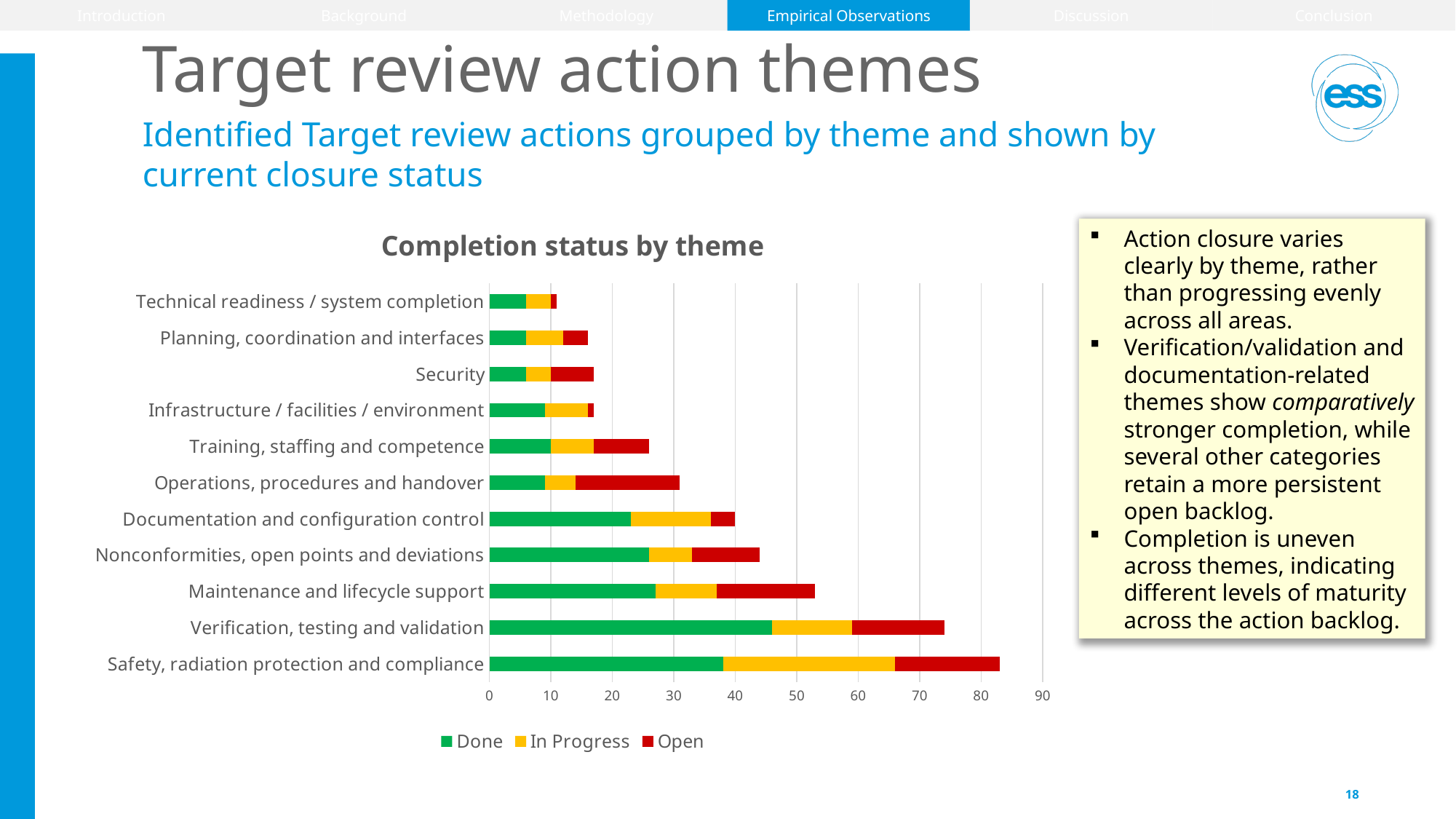
What kind of chart is shown on the slide? Stacked bar chart Is the total bar length for Technical readiness / system completion greater or less than 20? less How many series does the chart legend list? 3 How many themes (categories) are plotted in the chart? 11 What is the title of the chart? Completion status by theme Which theme has the lowest total number of actions? Technical readiness / system completion Is the total bar length for Maintenance and lifecycle support greater or less than 50? greater Which theme has the highest total number of actions? Safety, radiation protection and compliance Which theme has the largest Done segment? Verification, testing and validation Which colour represents the Done series in the chart? Green Which has a longer total bar: Verification, testing and validation or Maintenance and lifecycle support? Verification, testing and validation Is the total bar length for Verification, testing and validation greater or less than 70? greater